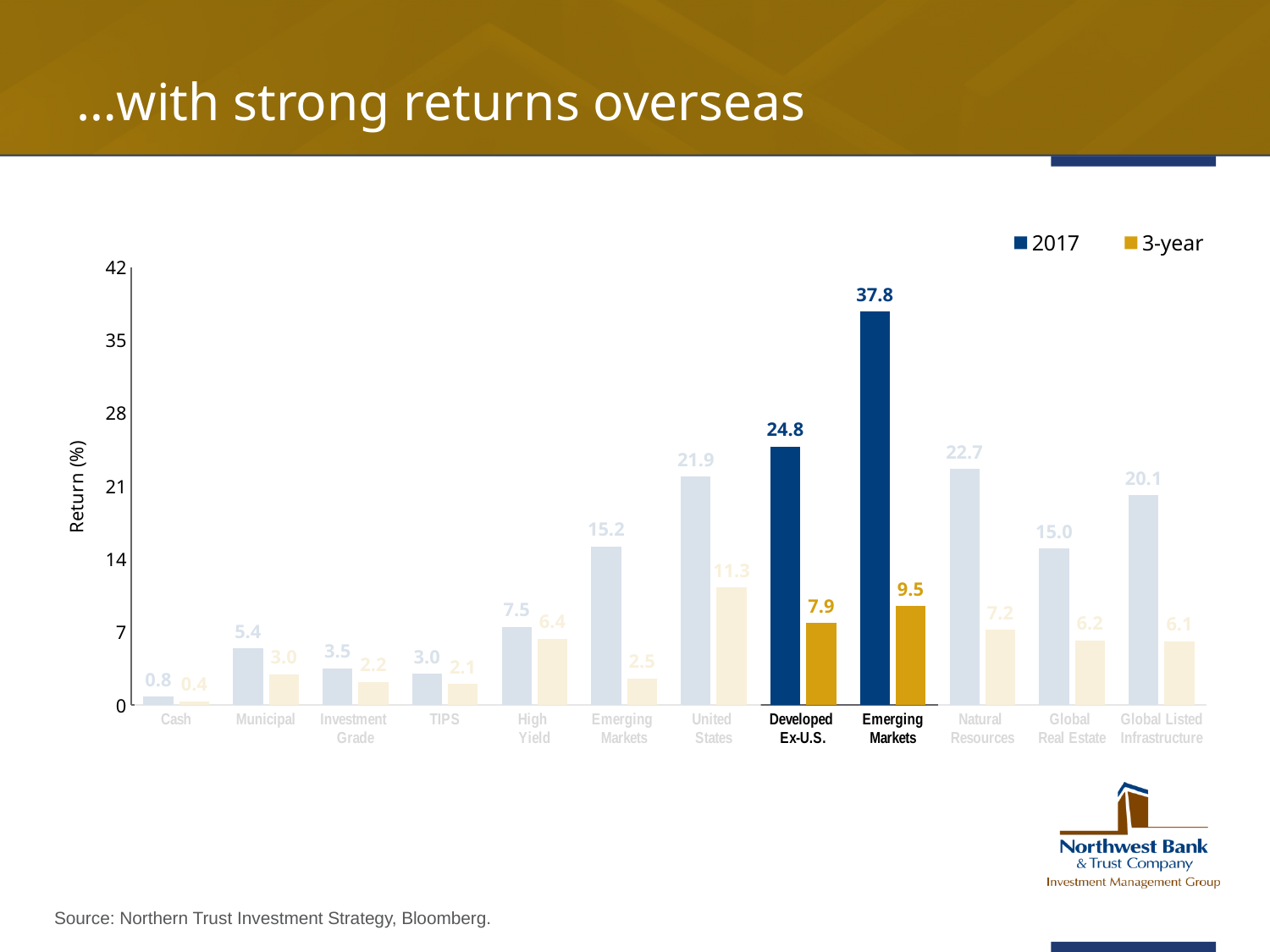
Which category has the highest 2017 return? Emerging Markets What is the 3-year return for Global Real Estate? 6.2 How many series does the legend list? 2 Which category has the highest 3-year return? United States What is the label on the y axis? Return (%) How many categories are shown along the x axis? 12 Which has the larger 2017 return, Natural Resources or Global Listed Infrastructure? Natural Resources What is the 2017 return for Developed Ex-U.S.? 24.8 What is the difference between the 2017 and 3-year returns for Developed Ex-U.S.? 16.9 What is the 3-year return for United States? 11.3 Which category has the lowest 2017 return? Cash What kind of chart is shown on the slide? bar chart